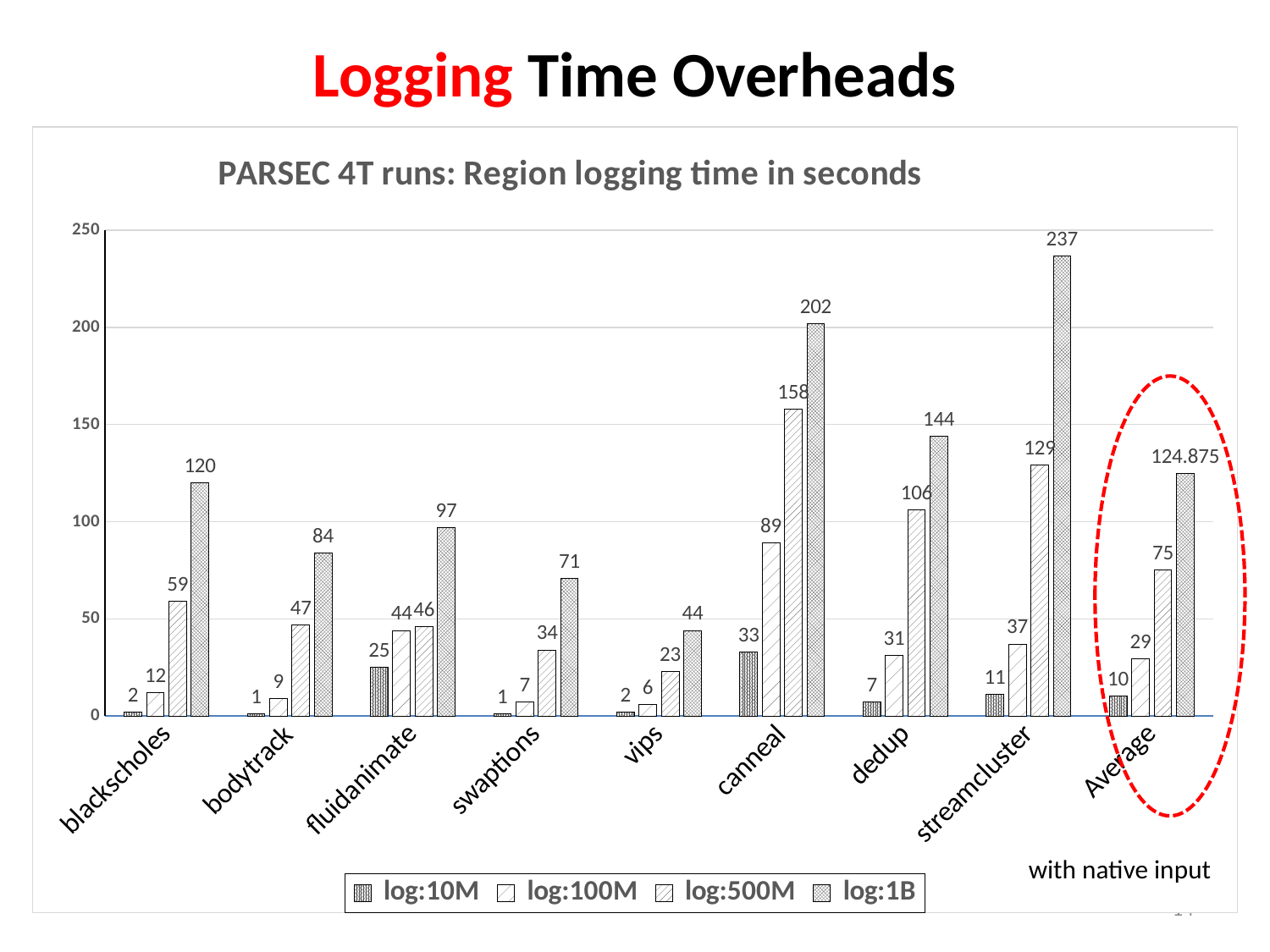
What is the log:10M value for fluidanimate? 25 How many series does the legend list? 4 What is the log:500M value for canneal? 158 What is the log:1B value for Average? 124.875 What kind of chart is this? bar chart Which is larger, the log:1B value for canneal or the log:1B value for blackscholes? canneal Which category has the lowest log:500M value? vips What is the difference between the log:1B and log:500M values for dedup? 38 What is the log:1B value for streamcluster? 237 What is the title of the chart? PARSEC 4T runs: Region logging time in seconds How many categories are shown on the x axis? 9 Which category has the highest log:1B value? streamcluster